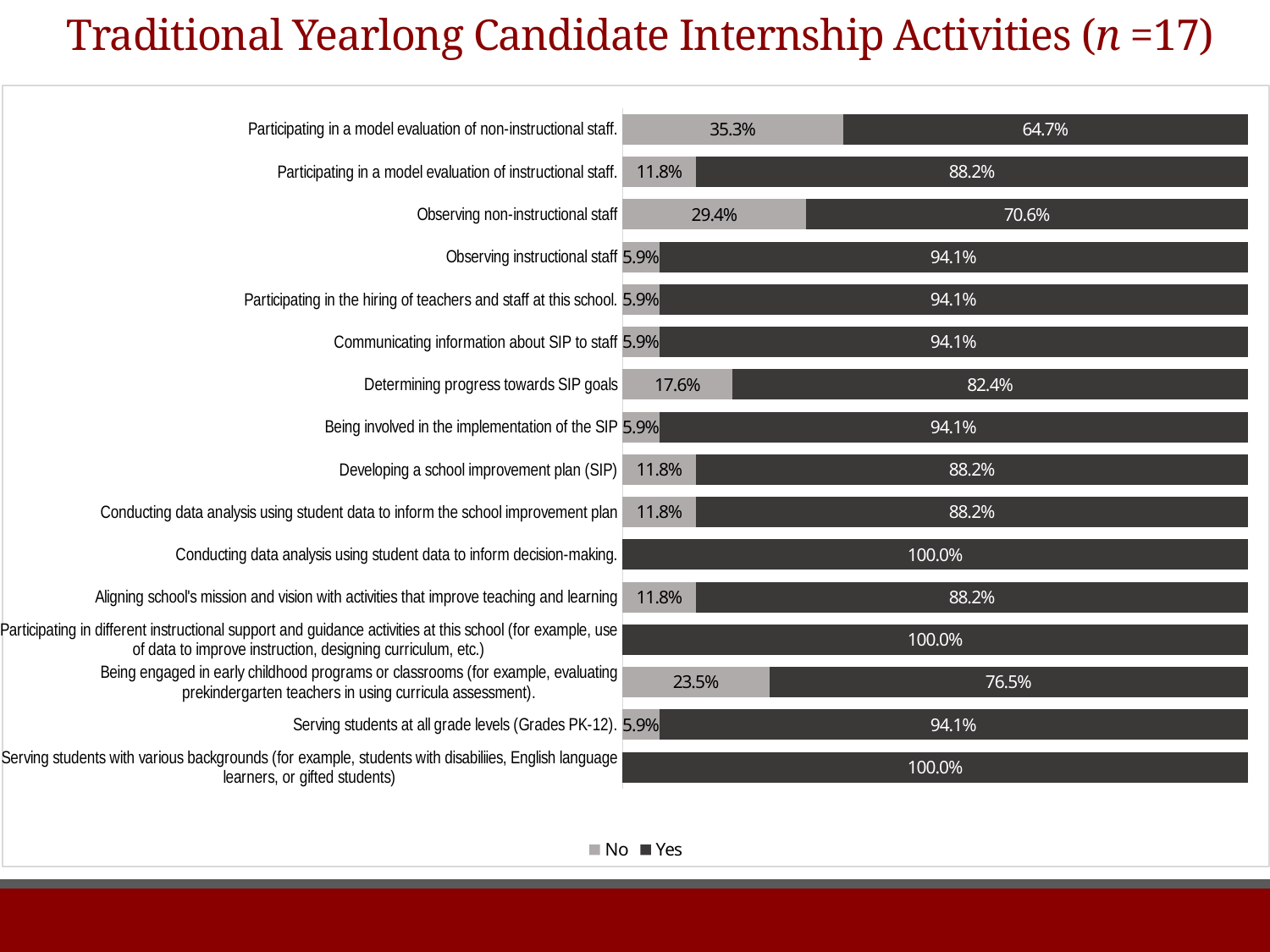
What is the sample size (n) given in the chart title? 17 What percentage of respondents answered Yes for "Observing non-instructional staff"? 70.6% What percentage of respondents answered No for "Determining progress towards SIP goals"? 17.6% How many activities are listed in the chart? 16 What is the Yes percentage for "Being engaged in early childhood programs or classrooms"? 76.5% What kind of chart is shown on the slide? Stacked bar chart Which has a larger Yes percentage: "Developing a school improvement plan (SIP)" or "Determining progress towards SIP goals"? Developing a school improvement plan (SIP) Which activity has the highest No percentage? Participating in a model evaluation of non-instructional staff. Which activity has the lowest Yes percentage? Participating in a model evaluation of non-instructional staff. What is the difference between the Yes percentages for "Observing instructional staff" and "Observing non-instructional staff"? 23.5% What is the total of the No and Yes segments for "Participating in a model evaluation of instructional staff."? 100.0% How many series does the legend list? 2